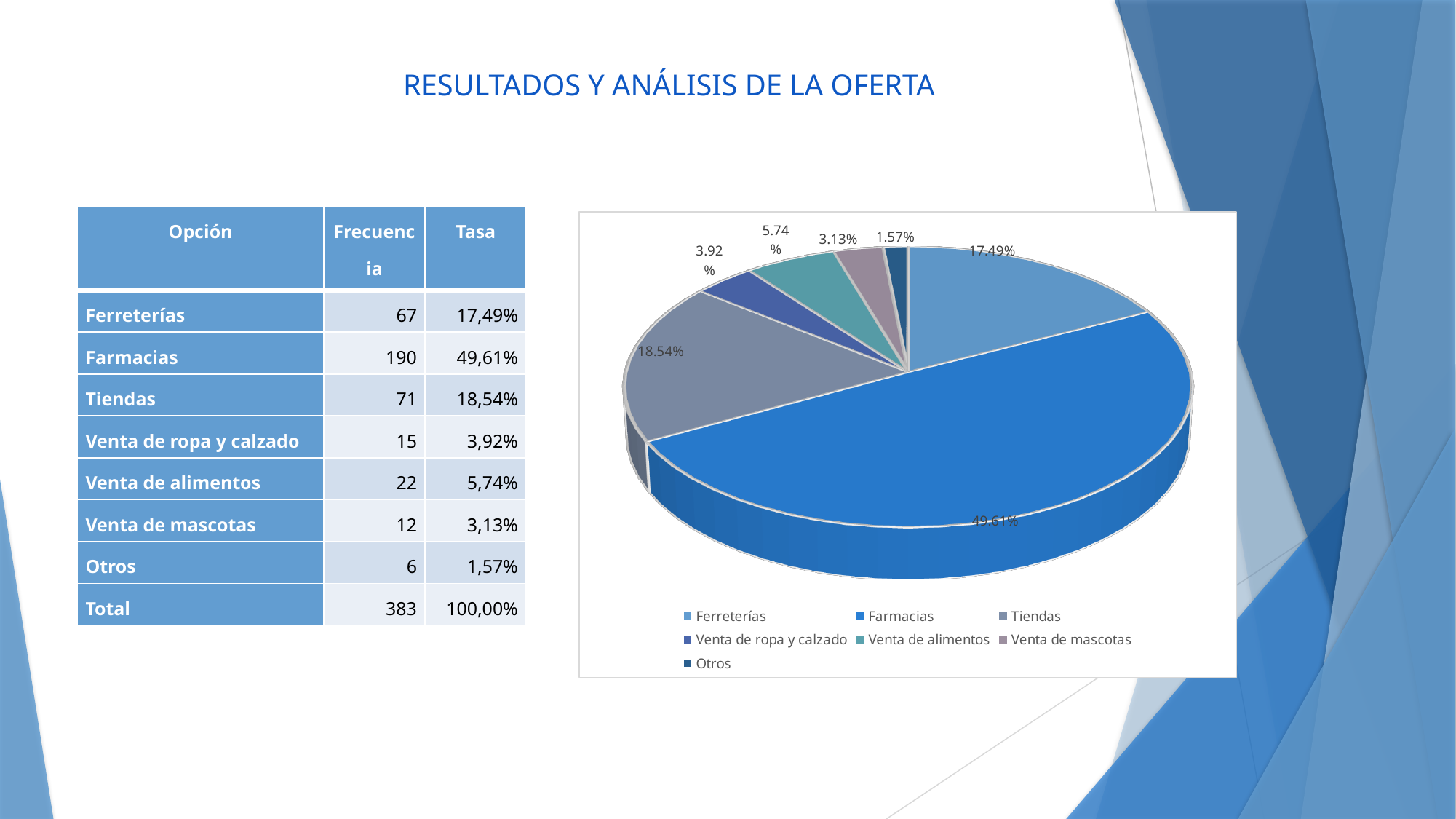
How many slices does the pie chart have? 7 What percentage does the pie chart show for Farmacias? 49.61% What percentage does the pie chart show for Venta de alimentos? 5.74% What is the difference in percentage points between the Farmacias slice and the Tiendas slice in the pie chart? 31.07 How many entries does the pie chart's legend list? 7 In the pie chart, which slice is larger: Tiendas or Ferreterías? Tiendas What percentage does the pie chart show for Tiendas? 18.54% What kind of chart is shown on the slide? Pie chart Which category has the largest slice in the pie chart? Farmacias What percentage does the pie chart show for Otros? 1.57% Which category has the smallest slice in the pie chart? Otros What percentage does the pie chart show for Ferreterías? 17.49%